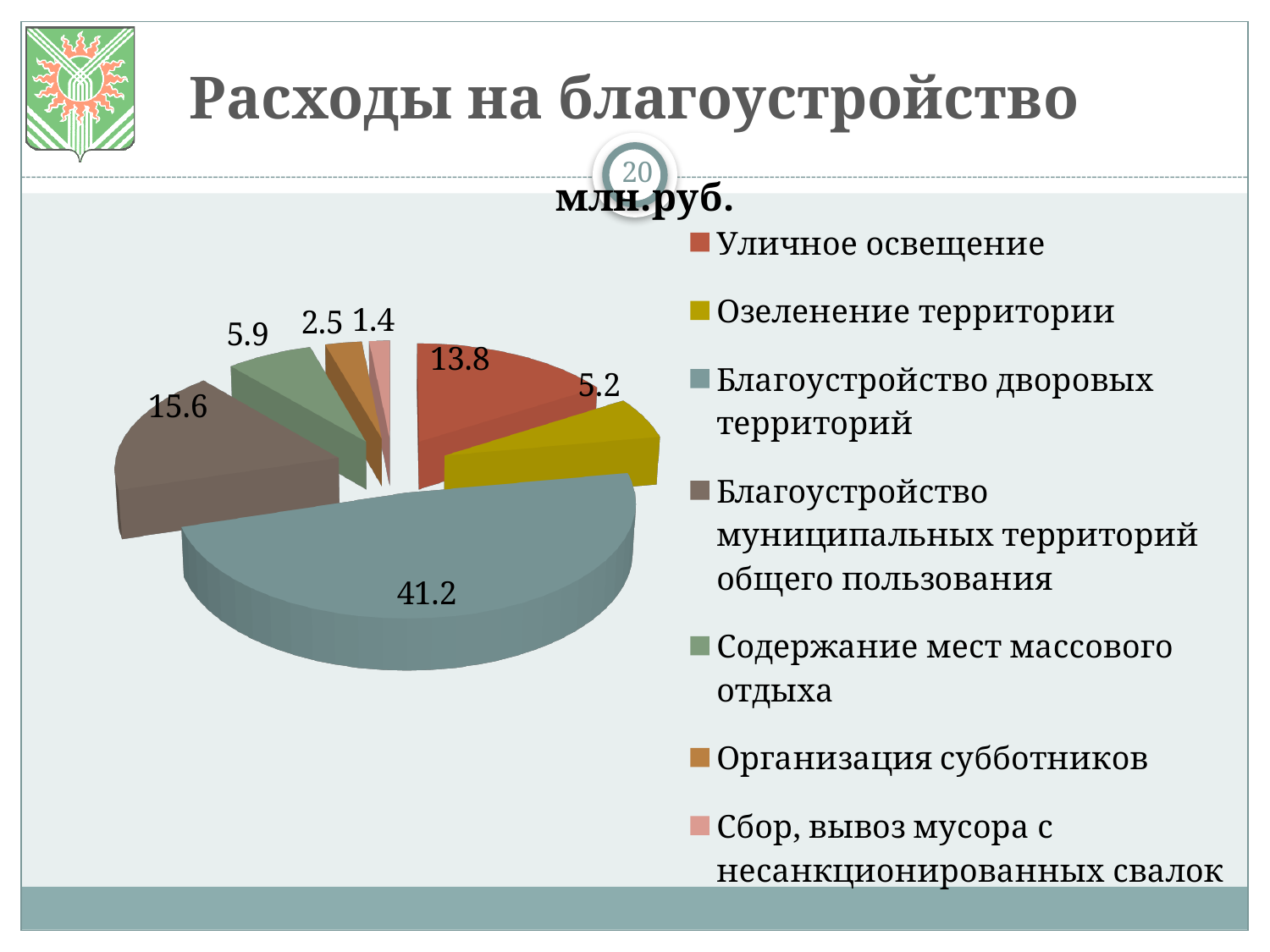
What is the value for Благоустройство дворовых территорий? 41.2 What is the value for Сбор, вывоз мусора с несанкционированных свалок? 1.4 What is the difference between the values for Благоустройство дворовых территорий and Благоустройство муниципальных территорий общего пользования? 25.6 What is the value for Уличное освещение? 13.8 What is the value for Организация субботников? 2.5 Which is larger, Содержание мест массового отдыха or Озеленение территории? Содержание мест массового отдыха Which category has the smallest value? Сбор, вывоз мусора с несанкционированных свалок What unit is given in the chart title? млн.руб. What is the difference between the values for Уличное освещение and Озеленение территории? 8.6 How many categories does the pie chart have? 7 Which category has the largest value? Благоустройство дворовых территорий What type of chart is shown on the slide? Pie chart